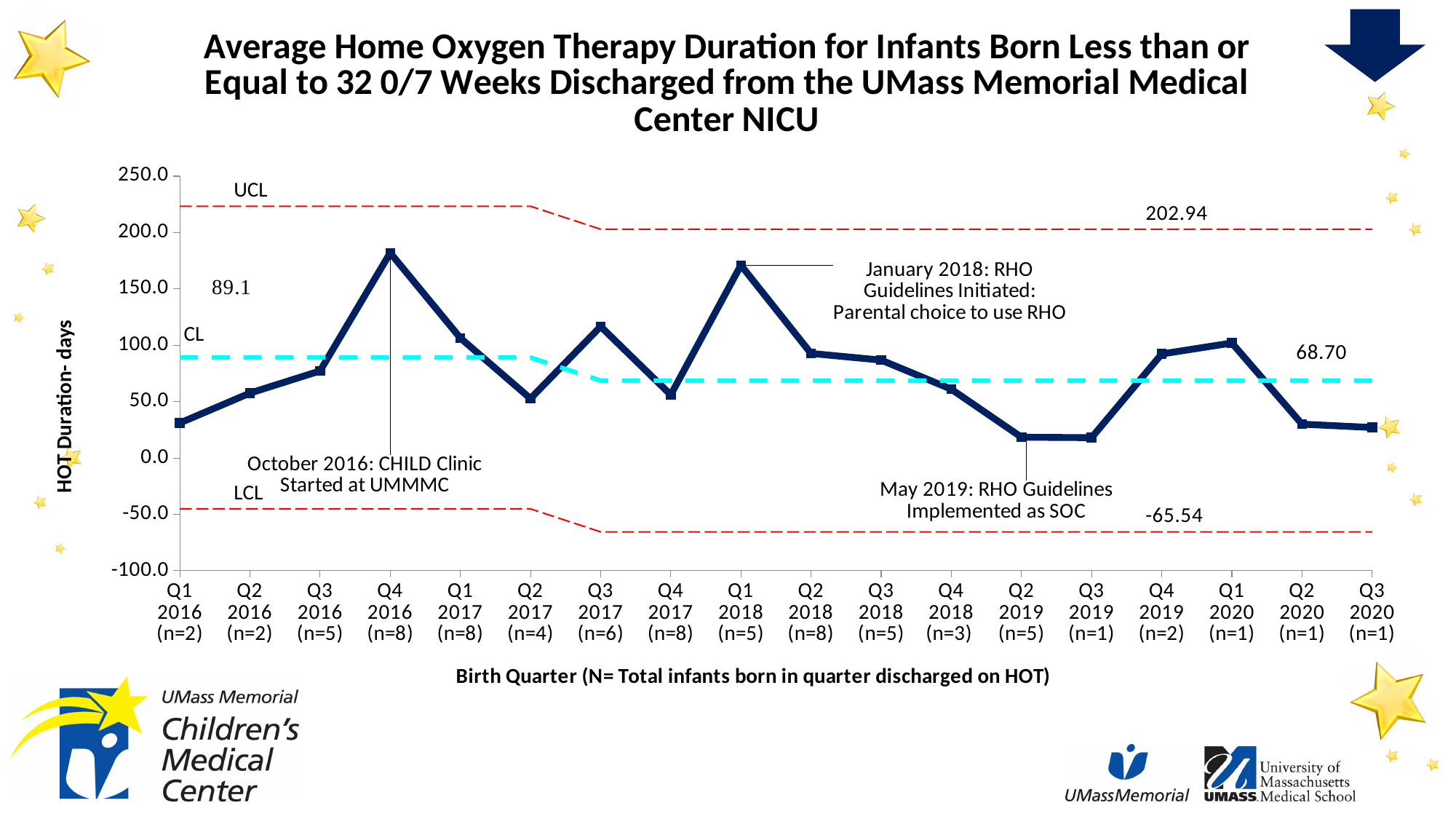
Is the value for Q4 2016 greater or less than 150? greater What is the value of the centre line (CL) in the later period of the chart? 68.70 What is the label on the y axis? HOT Duration- days What is the value of the lower control limit (LCL) in the later period of the chart? -65.54 What is the value of the upper control limit (UCL) in the later period of the chart? 202.94 Which birth quarter has the highest average HOT duration? Q4 2016 Is the value for Q2 2019 greater or less than 50? less What is the difference between the earlier centre line value (89.1) and the later centre line value (68.70)? 20.4 What is the value of the centre line (CL) in the earlier period of the chart? 89.1 What kind of chart is shown on the slide? line chart How many birth quarters are plotted along the x axis? 18 Which is larger, the value for Q3 2017 or the value for Q4 2017? Q3 2017